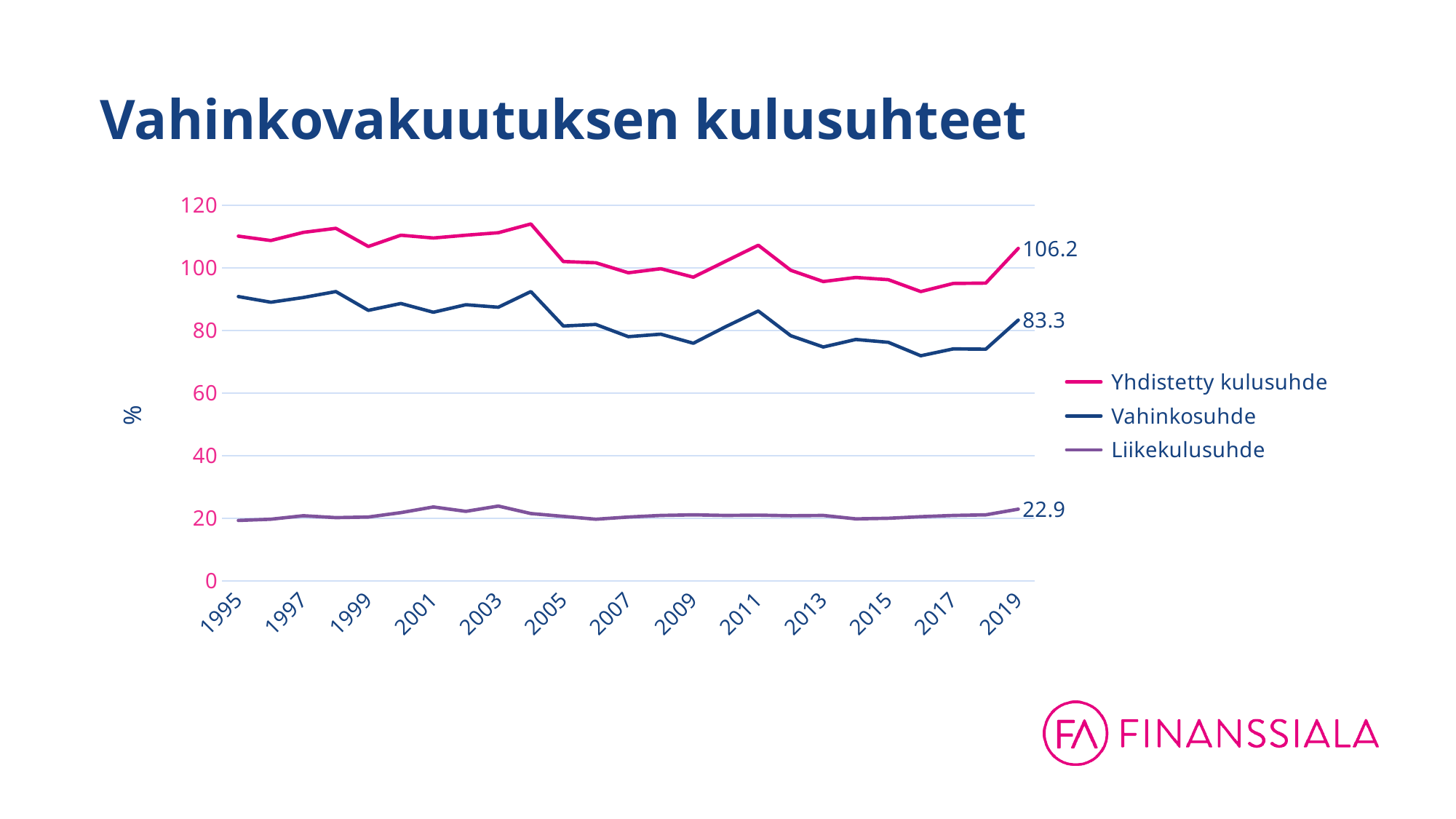
What is the value of Yhdistetty kulusuhde in 2019? 106.2 What is the difference between Yhdistetty kulusuhde and Vahinkosuhde in 2019? 22.9 What is the value of Liikekulusuhde in 2019? 22.9 What kind of chart is shown on the slide? Line chart What is the difference between Vahinkosuhde and Liikekulusuhde in 2019? 60.4 Which series has the highest value in 2019? Yhdistetty kulusuhde Does the Vahinkosuhde line rise or fall between 2011 and 2016? Fall Is the value for Vahinkosuhde in 2016 greater or less than 80? less Is the value for Yhdistetty kulusuhde in 2004 greater or less than 110? greater How many series does the legend list? 3 Which series has the lowest value in 2019? Liikekulusuhde What is the value of Vahinkosuhde in 2019? 83.3